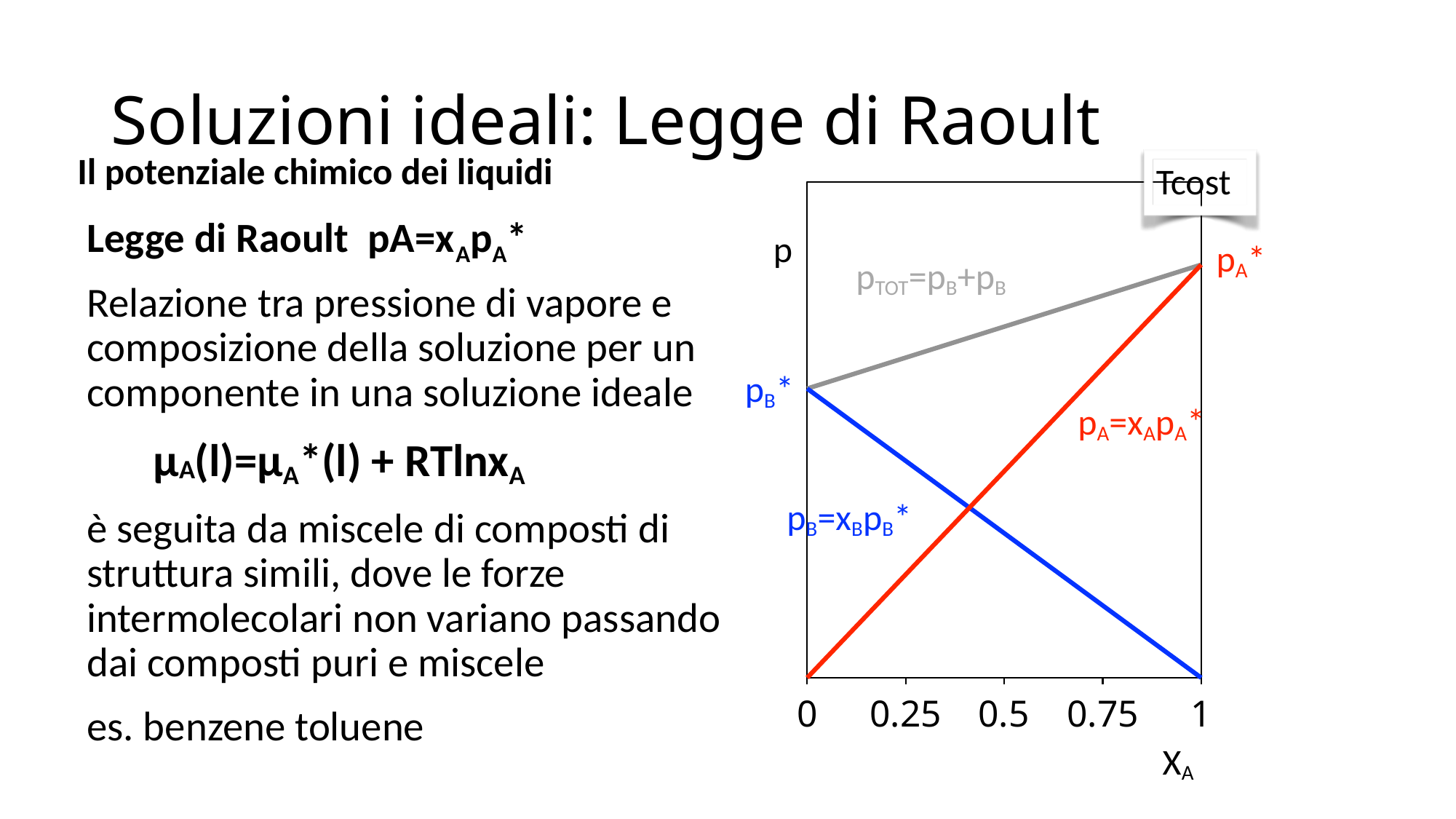
Does the blue line (pB=xBpB*) rise or fall as xA increases from 0 to 1? falls Which line is lowest at xA = 1? the blue line (pB=xBpB*) How many tick labels are shown on the x axis? 5 At xA = 0.75, which is higher: the red line or the blue line? the red line What kind of chart is shown on the slide? line chart Which line is lowest at xA = 0? the red line (pA=xApA*) What colour is the line labelled pA=xApA*? red Does the grey line (pTOT) rise or fall as xA increases from 0 to 1? rises At xA = 0.25, which is higher: the red line or the blue line? the blue line What is the label of the x axis of the chart? XA Does the red line (pA=xApA*) rise or fall as xA increases from 0 to 1? rises How many lines are plotted on the chart? 3